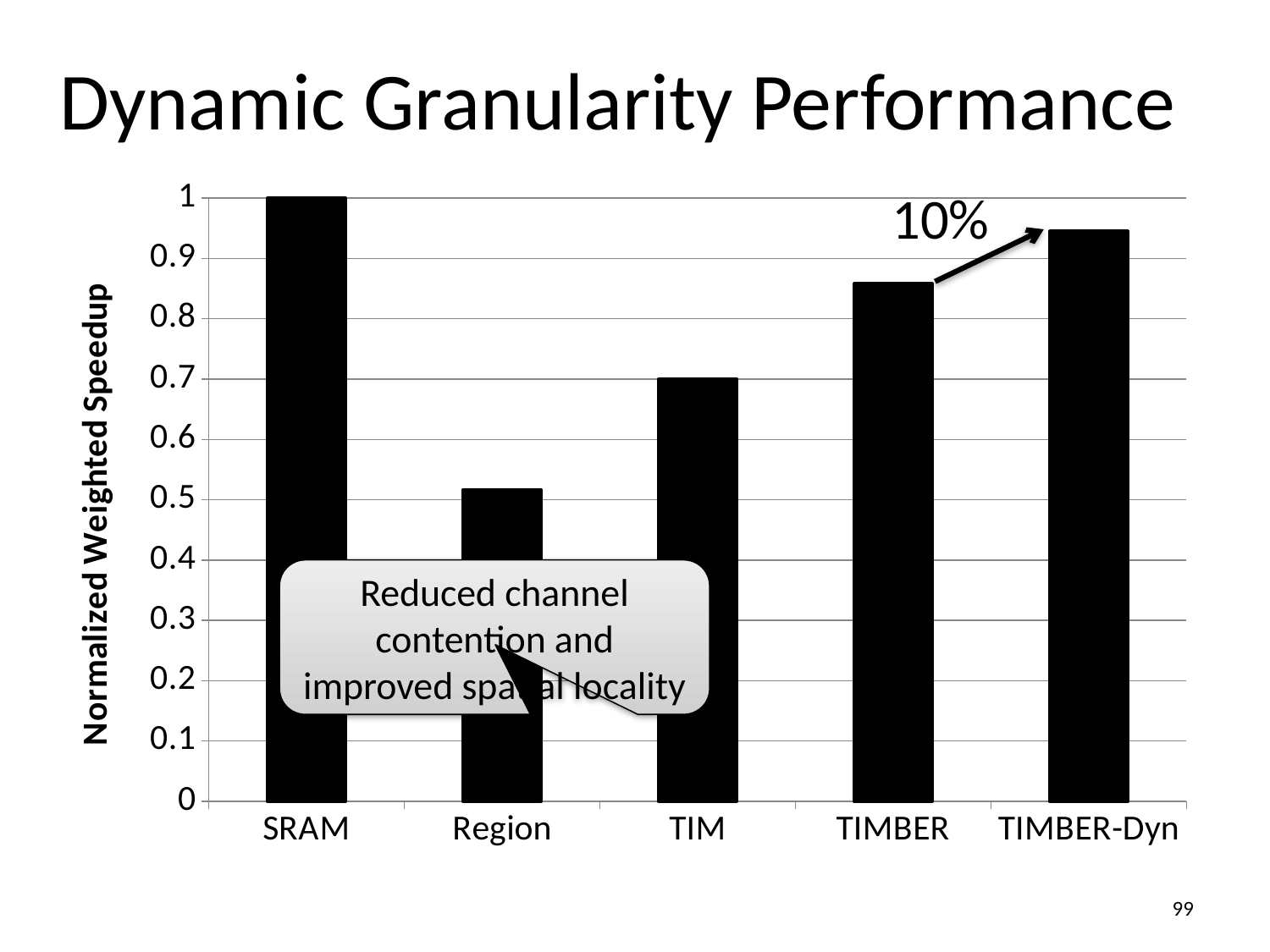
Is the value for TIMBER-Dyn greater or less than 0.9? greater Is the value for TIMBER greater or less than 0.8? greater Which category has the lowest normalized weighted speedup? Region Is the value for TIM greater or less than 0.6? greater How many categories are plotted on the x axis? 5 What kind of chart is shown on the slide? bar chart Which has a higher normalized weighted speedup, Region or TIM? TIM Which category has the highest normalized weighted speedup? SRAM What is the normalized weighted speedup for SRAM? 1 What is the label of the y axis? Normalized Weighted Speedup Which has a higher normalized weighted speedup, TIMBER or TIMBER-Dyn? TIMBER-Dyn